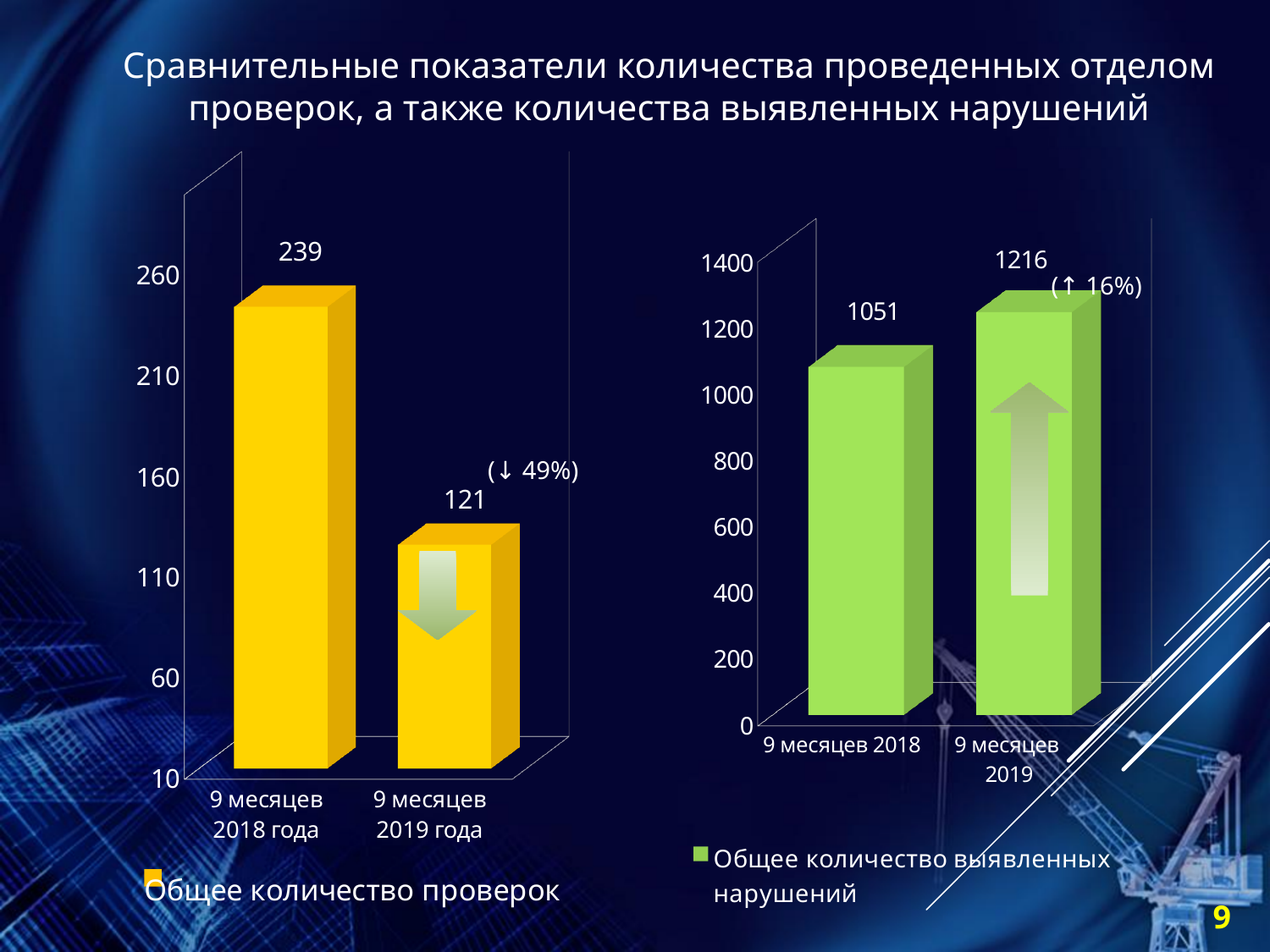
On the right chart (Общее количество выявленных нарушений), what is the value for 9 месяцев 2018? 1051 On the left chart (Общее количество проверок), what is the value for 9 месяцев 2019 года? 121 On the left chart (Общее количество проверок), what is the value for 9 месяцев 2018 года? 239 On the left chart, which period has the higher number of проверок? 9 месяцев 2018 года On the right chart (Общее количество выявленных нарушений), what is the value for 9 месяцев 2019? 1216 On the left chart, do the values rise or fall from 9 месяцев 2018 года to 9 месяцев 2019 года? fall On the right chart, which period has the lower number of выявленных нарушений? 9 месяцев 2018 On the right chart, is the value for 9 месяцев 2019 greater or less than 1200? greater On the right chart, what is the difference between the values for 9 месяцев 2019 and 9 месяцев 2018? 165 On the left chart, what is the difference between the values for 9 месяцев 2018 года and 9 месяцев 2019 года? 118 What percentage change is annotated next to the 2019 bar on the right chart? ↑ 16% What kind of chart is the left chart? bar chart